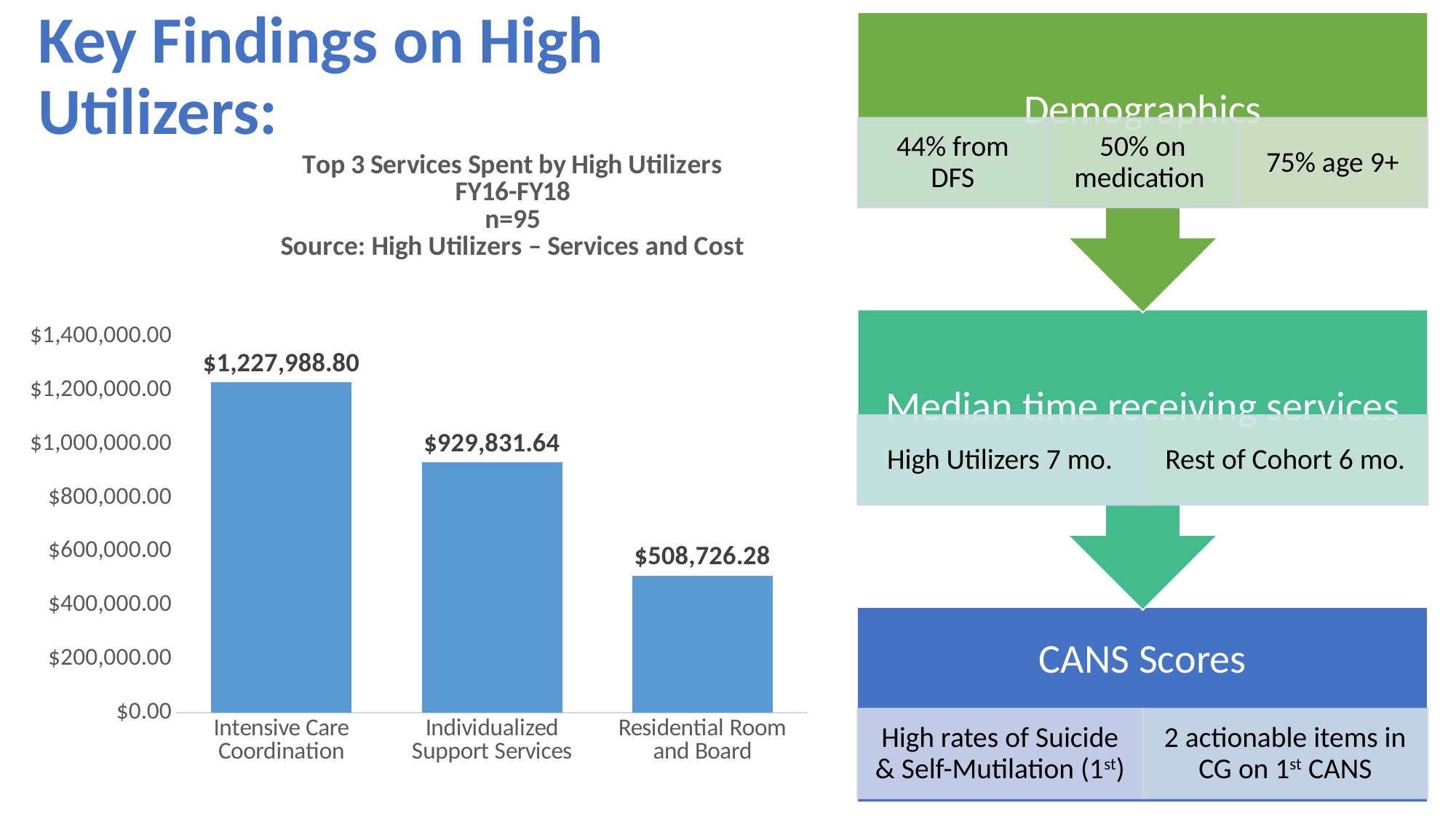
What kind of chart is shown on the slide? bar chart Which service has the lowest spending? Residential Room and Board What is the difference between the values for Individualized Support Services and Residential Room and Board? $421,105.36 What is the value for Residential Room and Board? $508,726.28 What is the sample size (n) stated in the chart title? n=95 How many services are shown in the chart? 3 What is the difference between the values for Intensive Care Coordination and Individualized Support Services? $298,157.16 Which service has the highest spending? Intensive Care Coordination Which is larger, the value for Individualized Support Services or the value for Residential Room and Board? Individualized Support Services Is the value for Residential Room and Board greater or less than $600,000.00? less What is the value for Individualized Support Services? $929,831.64 What is the value for Intensive Care Coordination? $1,227,988.80